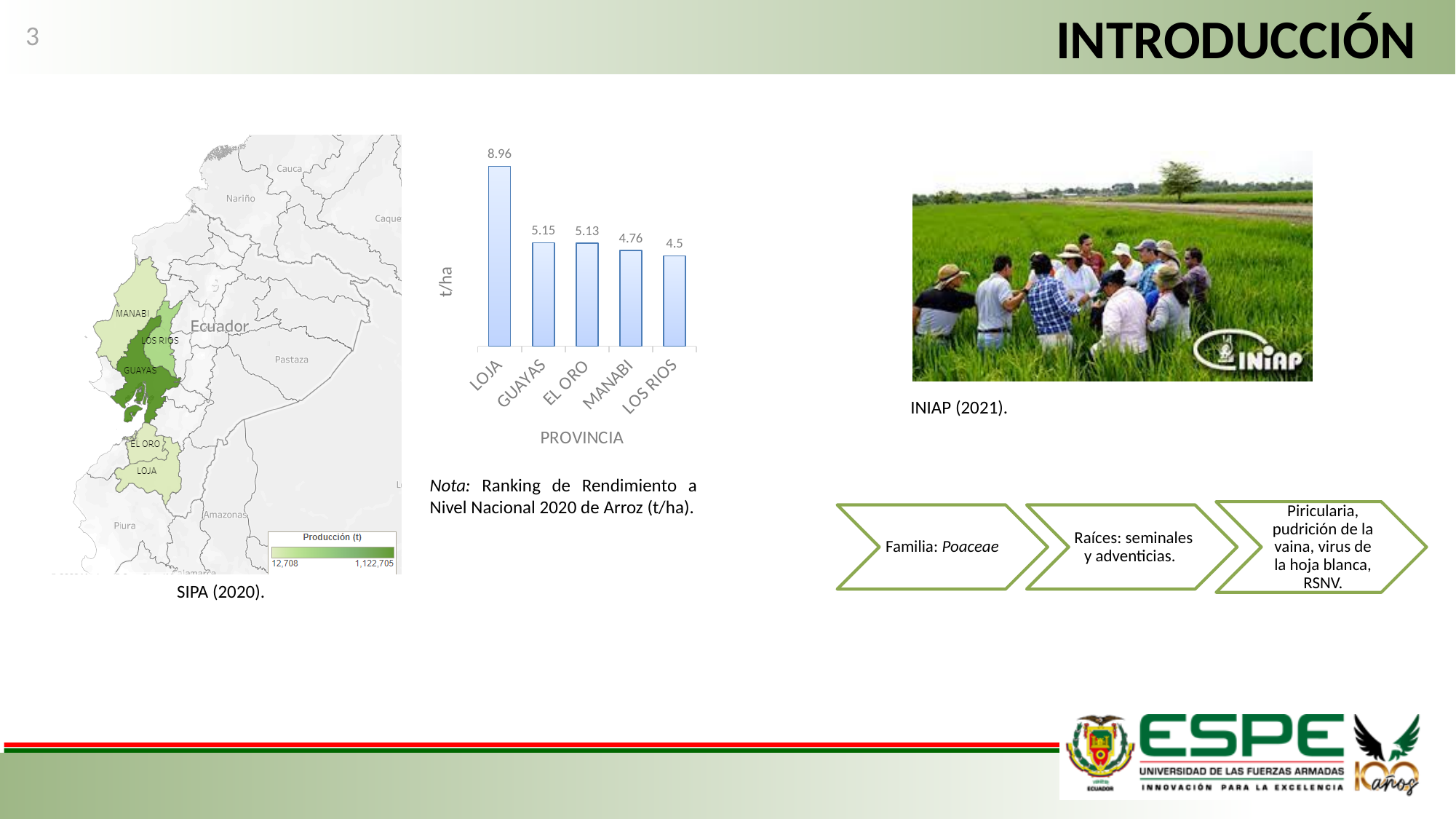
In the bar chart, which is larger, the value for LOJA or the value for EL ORO? LOJA What is the difference between the values for LOJA and GUAYAS in the bar chart? 3.81 What is the value shown for LOS RIOS in the bar chart? 4.5 What is the value shown for MANABI in the bar chart? 4.76 What is the difference between the values for MANABI and LOS RIOS in the bar chart? 0.26 How many provinces are shown in the bar chart? 5 What is the yield value shown for LOJA in the bar chart? 8.96 What kind of chart is used to show the rice yield by province? Bar chart What is the label of the vertical axis of the bar chart? t/ha What is the value shown for GUAYAS in the bar chart? 5.15 Which province has the highest value in the bar chart? LOJA Which province has the lowest value in the bar chart? LOS RIOS